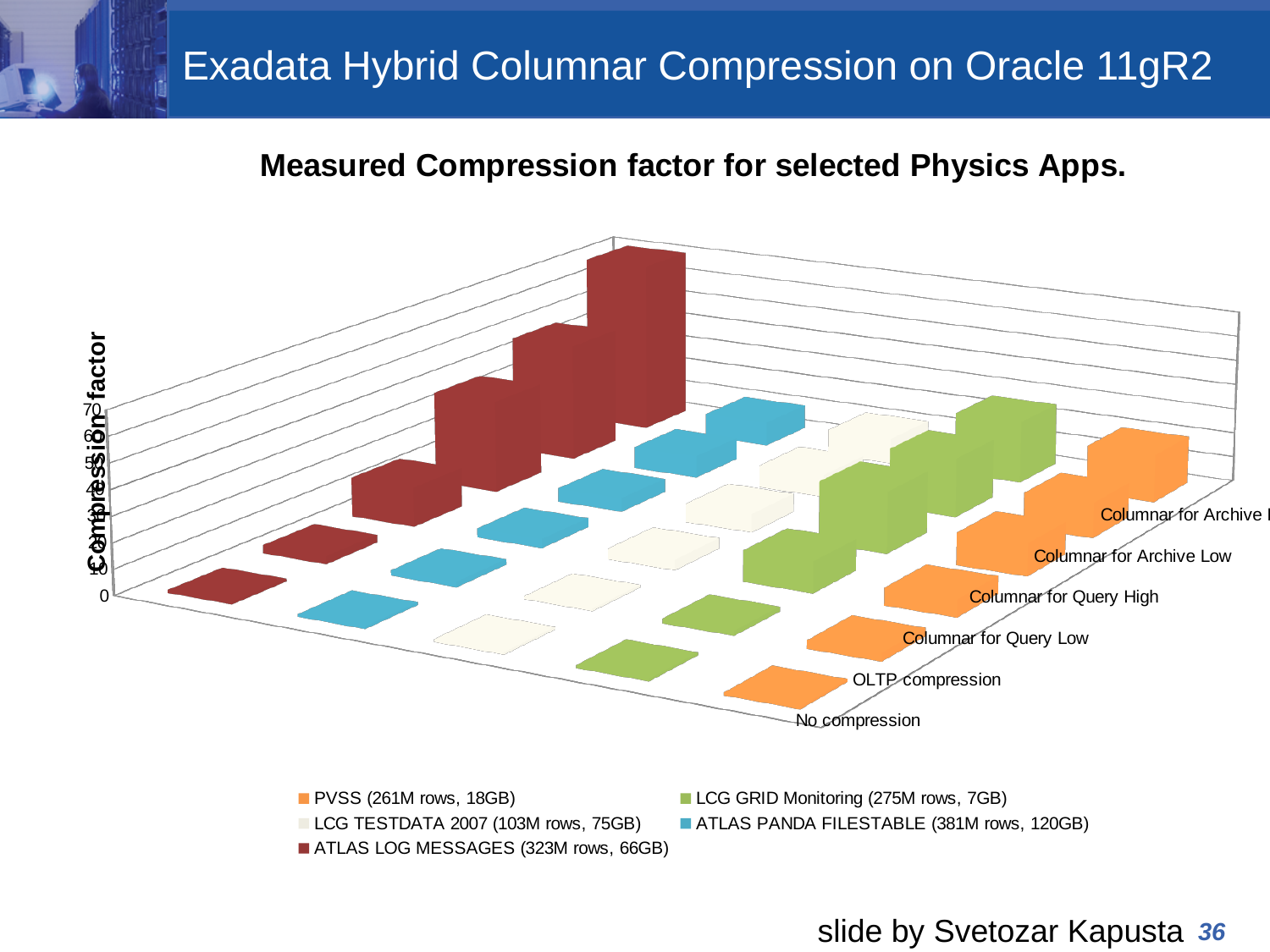
Which series has the tallest bar on the chart? ATLAS LOG MESSAGES (323M rows, 66GB) Which compression category has the lowest values across all series? No compression Do the values for ATLAS LOG MESSAGES rise or fall moving from No compression toward the Columnar for Archive categories? rise What kind of chart is shown on the slide? bar chart How many series does the legend list? 5 For Columnar for Query High, which is larger: the value for ATLAS LOG MESSAGES or the value for LCG TESTDATA 2007? ATLAS LOG MESSAGES What is the title of the chart? Measured Compression factor for selected Physics Apps. For Columnar for Archive Low, which is larger: the value for ATLAS LOG MESSAGES or the value for PVSS? ATLAS LOG MESSAGES What is the label of the vertical axis? Compression factor How many compression categories are plotted along the x axis? 6